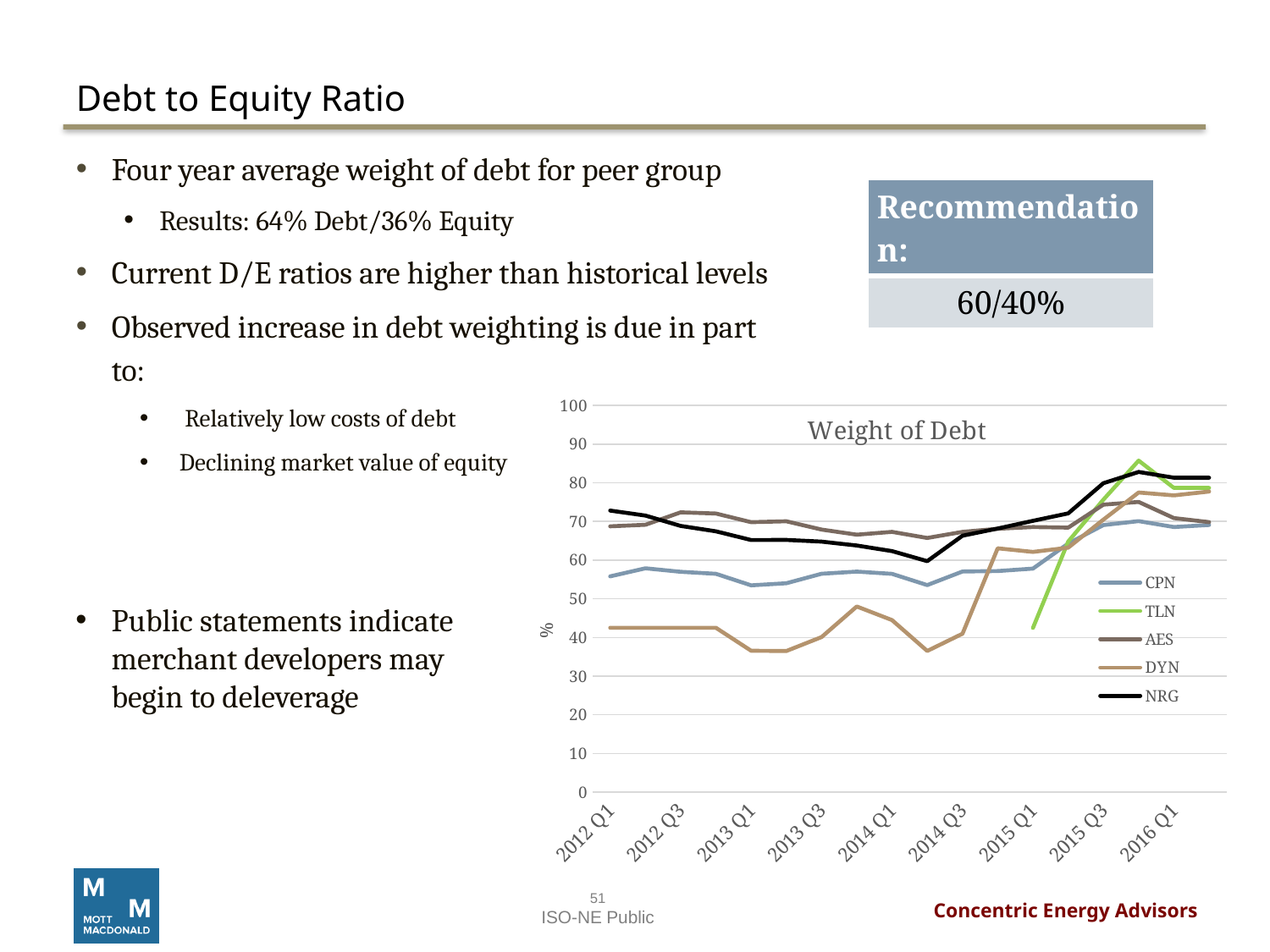
Which series has the lowest weight of debt at 2013 Q1? DYN What is the label on the y axis of the Weight of Debt chart? % Is the value for TLN at 2015 Q3 greater or less than 80? less Which series has the highest weight of debt at 2012 Q1? NRG How many series does the legend of the Weight of Debt chart list? 5 How many quarter labels are shown along the x axis of the Weight of Debt chart? 9 Does the NRG line rise or fall between 2012 Q1 and 2014 Q1? fall Is the value for NRG at 2012 Q1 greater or less than 70? greater Is the value for DYN at 2013 Q1 greater or less than 40? less What kind of chart is the Weight of Debt chart? line chart What is the title of the chart on the slide? Weight of Debt